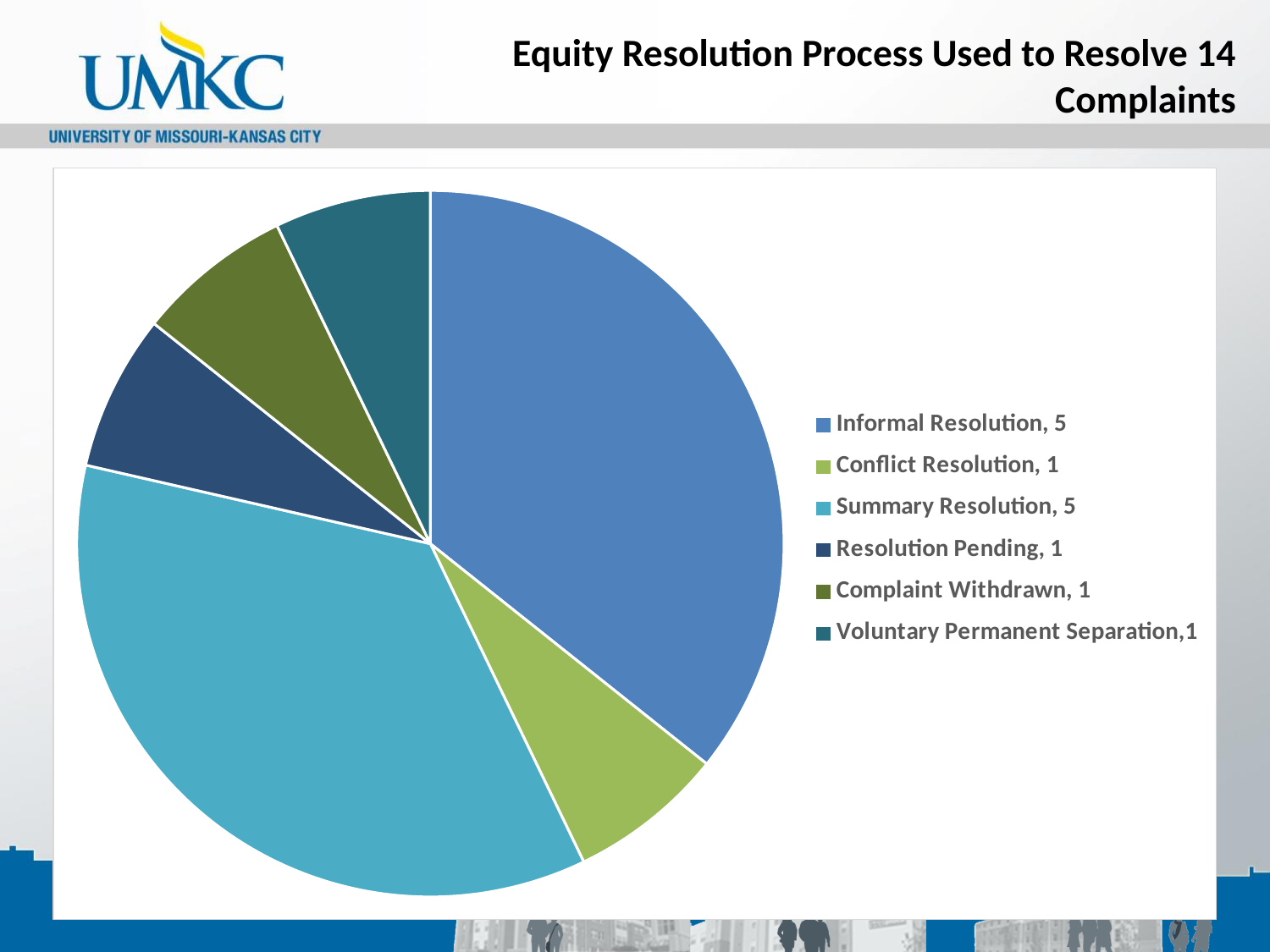
How many categories does the pie chart have? 6 How many complaints were resolved through Conflict Resolution? 1 How many complaints were withdrawn (Complaint Withdrawn)? 1 How many complaints were resolved through Summary Resolution? 5 What is the title of the chart on the slide? Equity Resolution Process Used to Resolve 14 Complaints How many complaints are listed as Resolution Pending? 1 How many complaints were resolved through Informal Resolution? 5 What is the total number of complaints represented in the pie chart? 14 Which is larger, the number of complaints resolved by Informal Resolution or by Conflict Resolution? Informal Resolution What is the difference between the number of complaints resolved by Summary Resolution and the number listed as Resolution Pending? 4 What kind of chart is shown on the slide? pie chart How many complaints were resolved by Voluntary Permanent Separation? 1